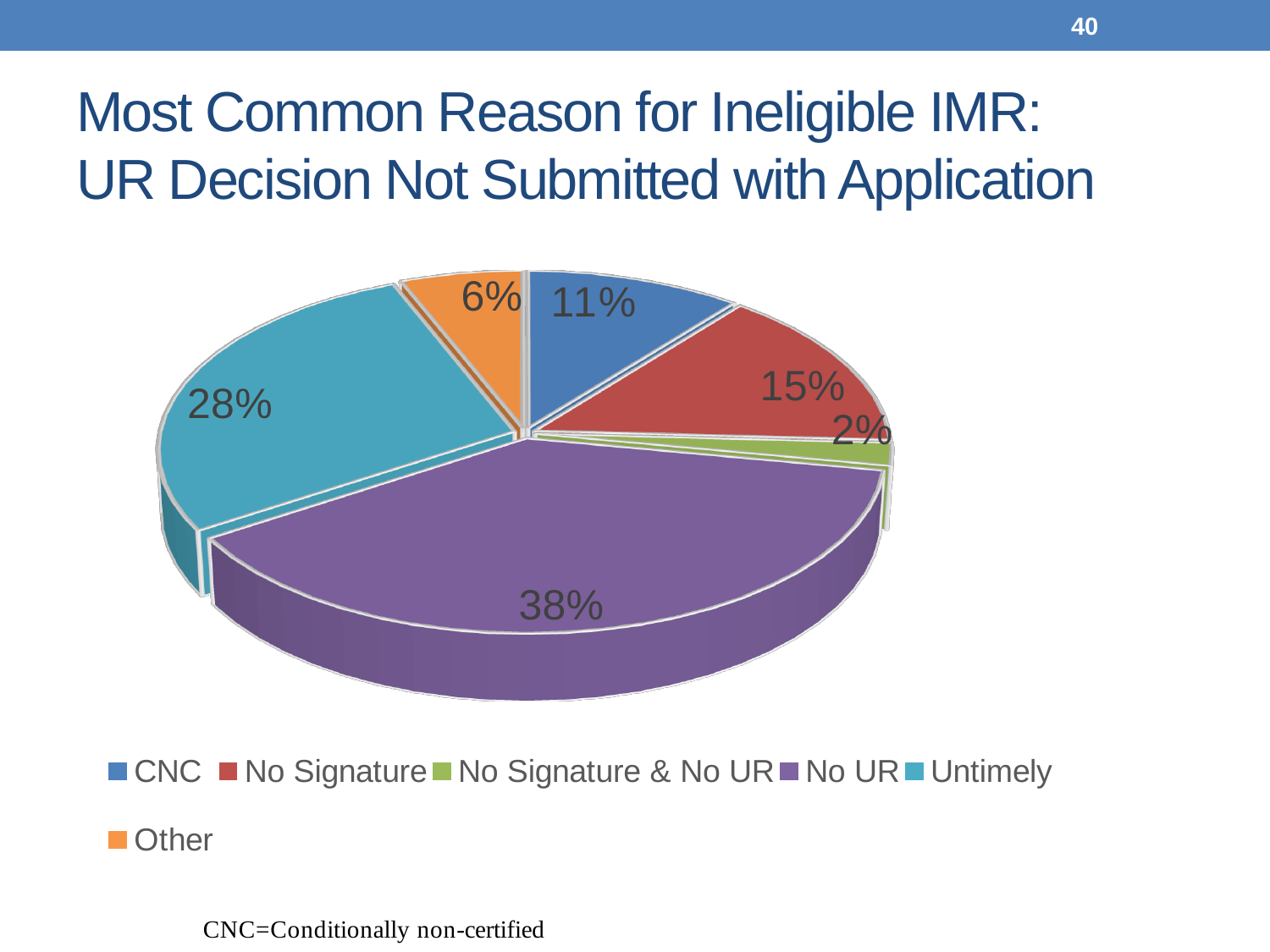
Which is larger, the share for No Signature or the share for CNC? No Signature What is the value for CNC? 11% Which category has the smallest slice of the pie? No Signature & No UR What is the value for Other? 6% How many categories does the legend list? 6 What share of the pie does Untimely represent? 28% What is the value for No Signature & No UR? 2% What is the value for No Signature? 15% What share of the pie does No UR represent? 38% What is the difference between the No UR and Untimely shares? 10% Which category has the largest slice of the pie? No UR What kind of chart is shown on the slide? Pie chart